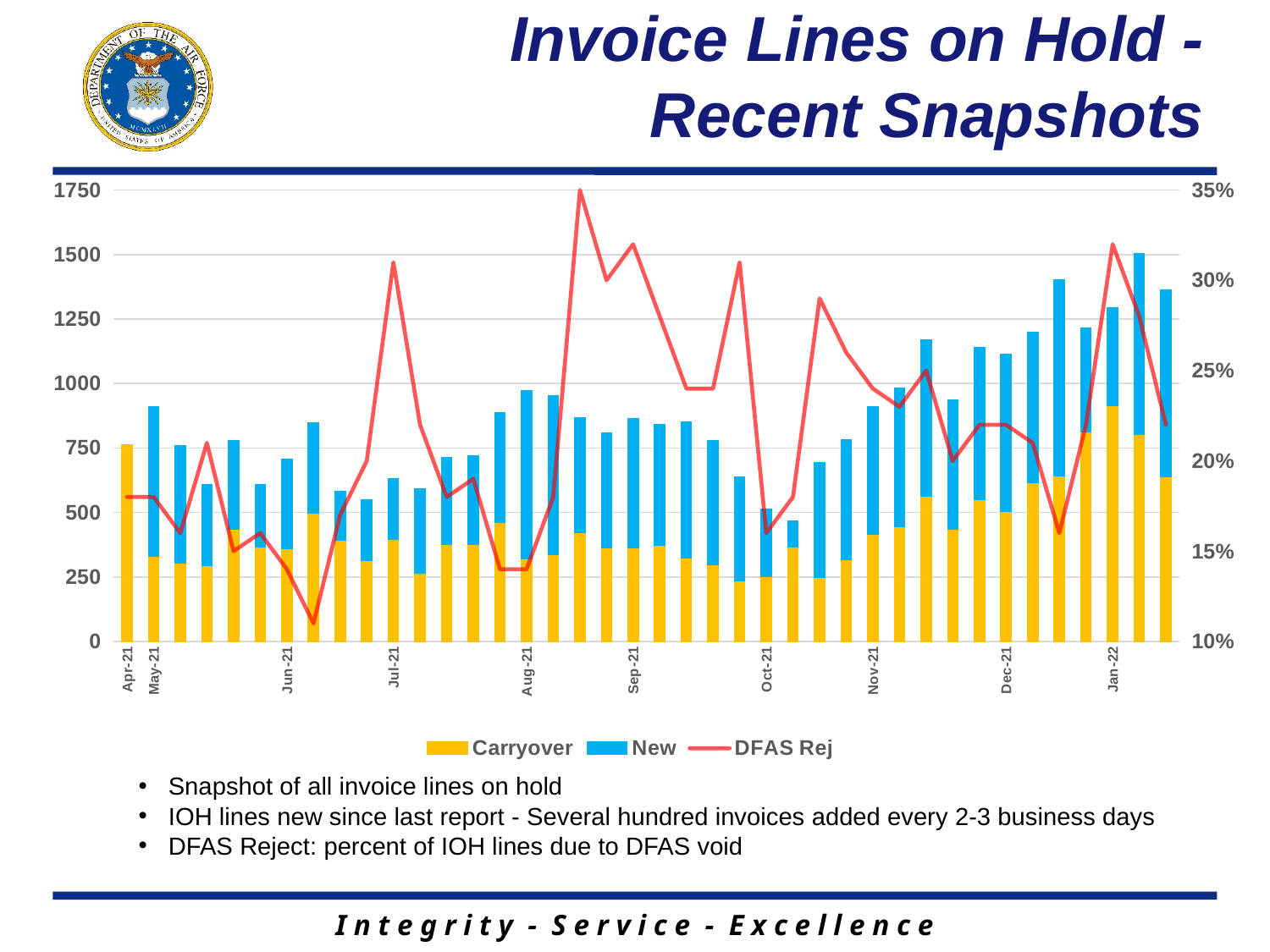
In which month does the DFAS Rej line reach its highest point? Aug-21 Is the highest point of the DFAS Rej line greater or less than 30%? greater How many month labels are shown on the x axis? 10 Do the total bar heights generally rise or fall from Apr-21 to Jan-22? rise How many series does the legend list? 3 Which bar is taller, Apr-21 or May-21? May-21 Which series is plotted as a line rather than bars? DFAS Rej What kind of chart is shown on the slide? Combined bar and line chart What are the three series named in the legend? Carryover, New, DFAS Rej In which month does the DFAS Rej line reach its lowest point? Jun-21 Is the total bar height for Apr-21 greater or less than 500? greater Is the DFAS Rej value at Apr-21 greater or less than 15%? greater